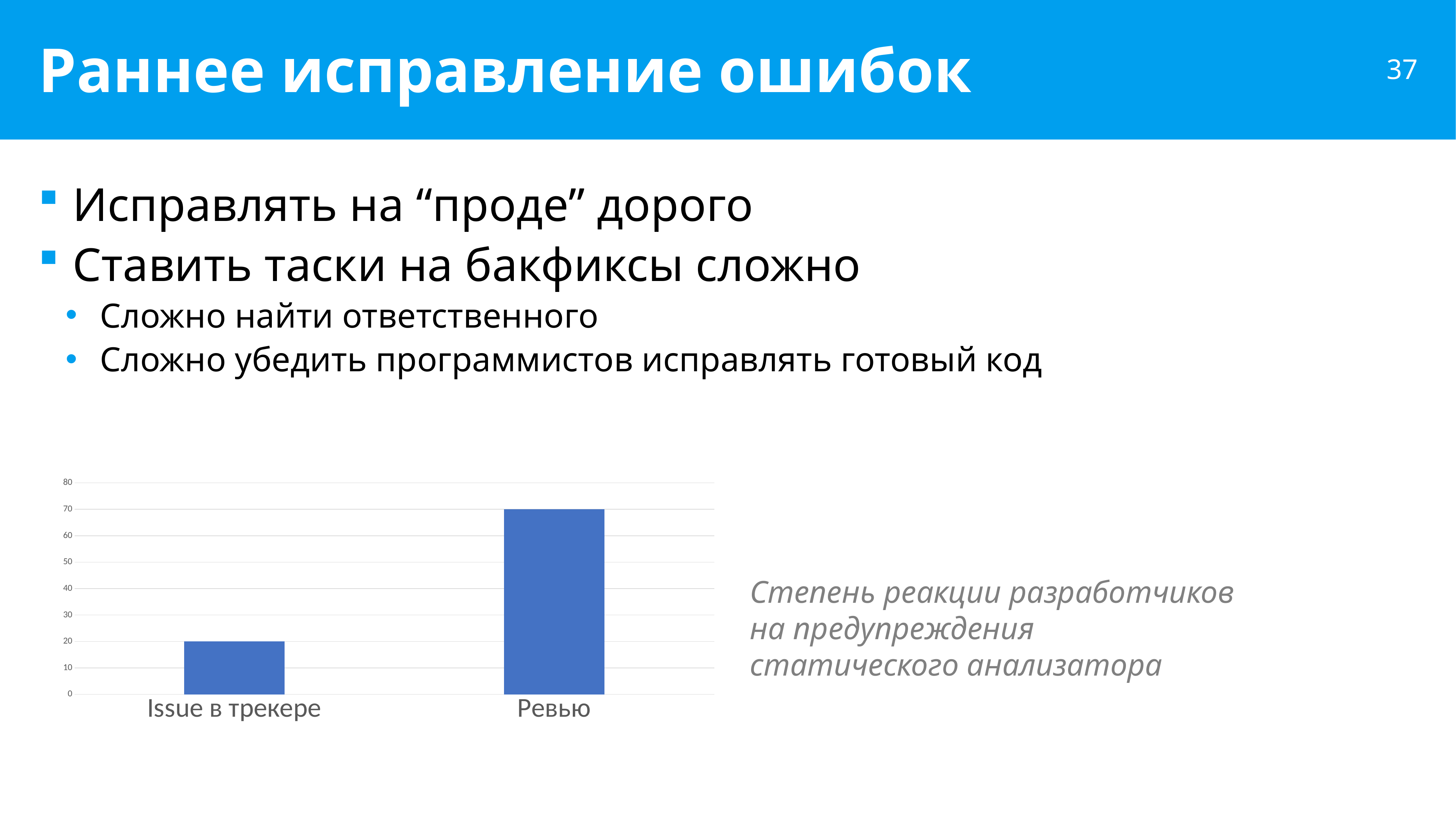
Which is larger: the value for "Ревью" or the value for "Issue в трекере"? Ревью What is the value for "Issue в трекере" in the bar chart? 20 Is the value for "Ревью" greater or less than 50? greater Is the value for "Issue в трекере" greater or less than 40? less What colour are the bars in the chart? blue What kind of chart is shown on the slide? bar chart Which category has the highest value in the bar chart? Ревью What is the value for "Ревью" in the bar chart? 70 What is the difference between the values for "Ревью" and "Issue в трекере"? 50 Which category has the lowest value in the bar chart? Issue в трекере How many categories does the bar chart show? 2 What is the highest tick value shown on the vertical axis of the bar chart? 80